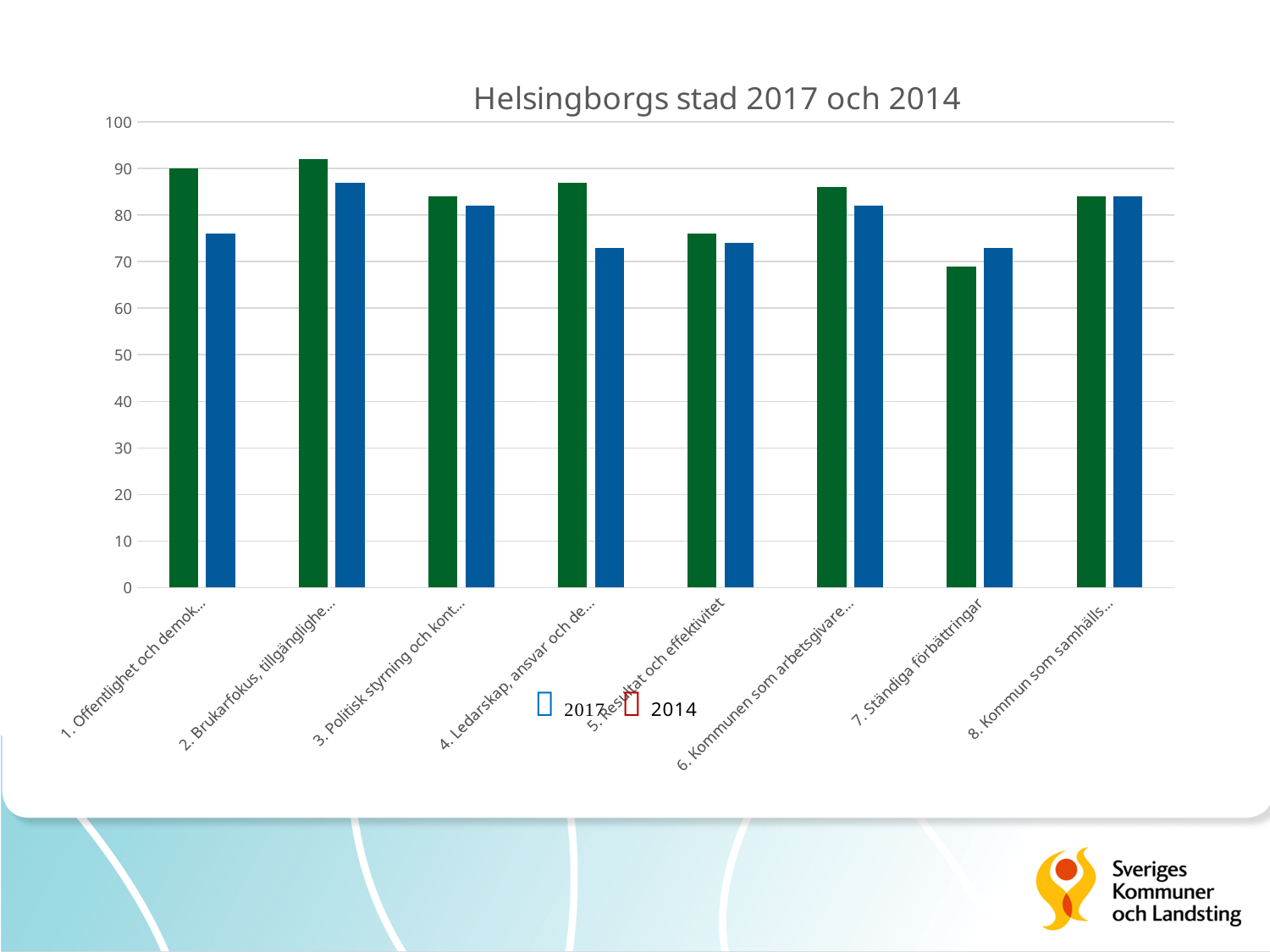
Is the value of the blue bar for "5. Resultat och effektivitet" greater or less than 70? greater For "7. Ständiga förbättringar", which bar is taller, the green bar or the blue bar? the blue bar Among the green bars, which category has the lowest value? 7. Ständiga förbättringar What kind of chart is shown on the slide? bar chart What is the title of the chart? Helsingborgs stad 2017 och 2014 What is the value of the green bar for category "1. Offentlighet och demok..."? 90 Is the value of the green bar for "7. Ständiga förbättringar" greater or less than 80? less How many categories are shown along the x axis of the chart? 8 Which two entries does the chart's legend list? 2017 and 2014 How many series does the chart's legend list? 2 For "1. Offentlighet och demok...", which bar is taller, the green bar or the blue bar? the green bar Is the value of the blue bar for "1. Offentlighet och demok..." greater or less than 80? less